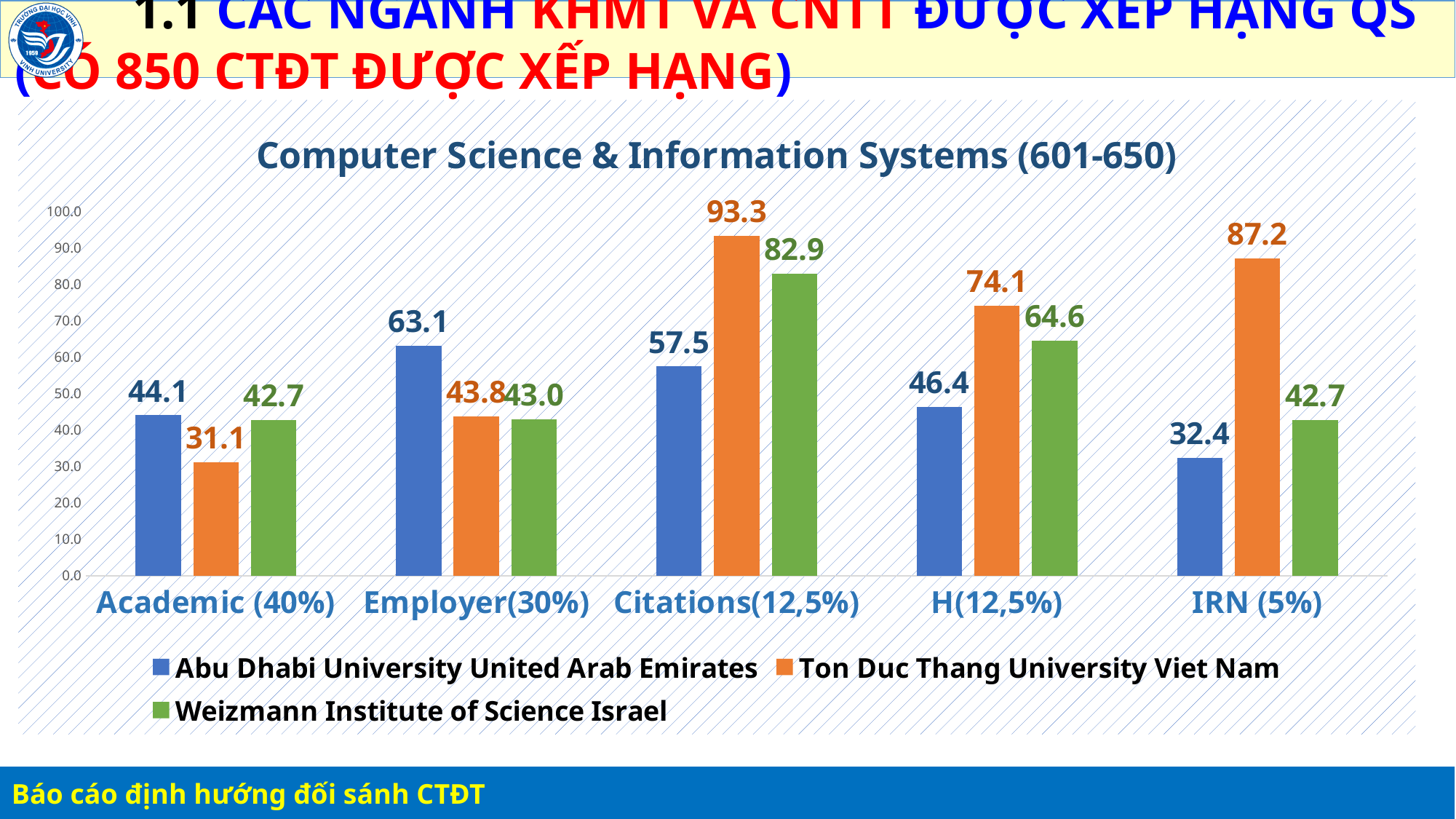
What is the value for Ton Duc Thang University Viet Nam in the Citations(12,5%) category? 93.3 How many series does the legend list? 3 What is the title of the chart? Computer Science & Information Systems (601-650) How many categories are shown on the x axis? 5 What is the difference between Ton Duc Thang University Viet Nam and Weizmann Institute of Science Israel in the IRN (5%) category? 44.5 Which is larger in the Academic (40%) category: Abu Dhabi University United Arab Emirates or Ton Duc Thang University Viet Nam? Abu Dhabi University United Arab Emirates What kind of chart is shown on the slide? Bar chart Is the value for Ton Duc Thang University Viet Nam in the H(12,5%) category greater or less than 70.0? greater What is the value for Abu Dhabi University United Arab Emirates in the Employer(30%) category? 63.1 In which category does Abu Dhabi University United Arab Emirates have its lowest value? IRN (5%) In which category does Ton Duc Thang University Viet Nam have its highest value? Citations(12,5%) What is the value for Weizmann Institute of Science Israel in the H(12,5%) category? 64.6